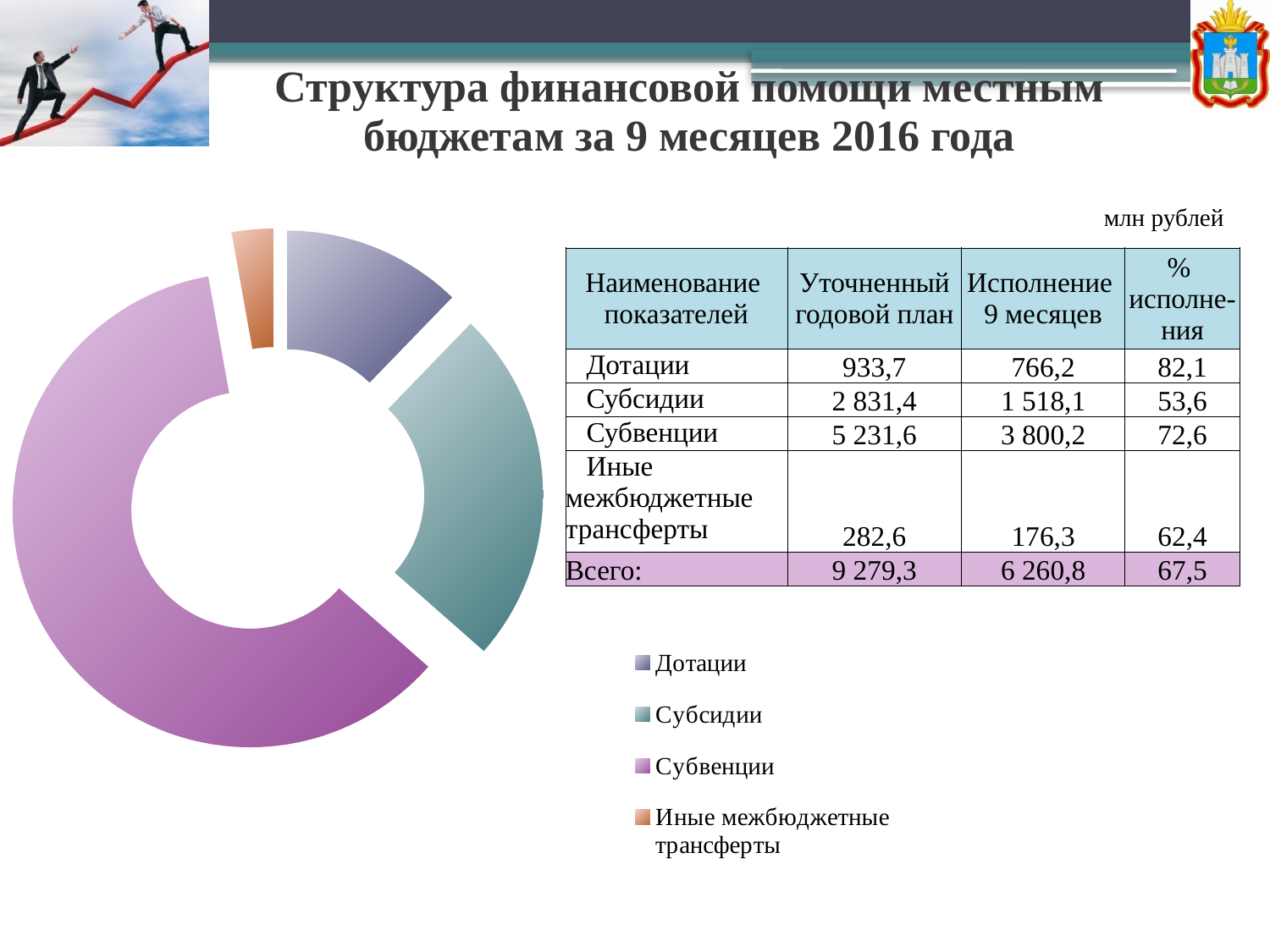
Which category has the smallest slice in the doughnut chart? Иные межбюджетные трансферты What kind of chart is shown on the left of the slide? Doughnut (pie) chart Which category has the largest slice in the doughnut chart? Субвенции How many categories does the doughnut chart show? 4 In the doughnut chart, which slice is larger: Субвенции or Субсидии? Субвенции In the doughnut chart, which slice is larger: Субсидии or Дотации? Субсидии How many entries does the legend of the doughnut chart list? 4 What colour is the Субвенции slice in the doughnut chart? Purple In the doughnut chart, which slice is larger: Дотации or Иные межбюджетные трансферты? Дотации Which legend entry is listed first in the doughnut chart's legend? Дотации